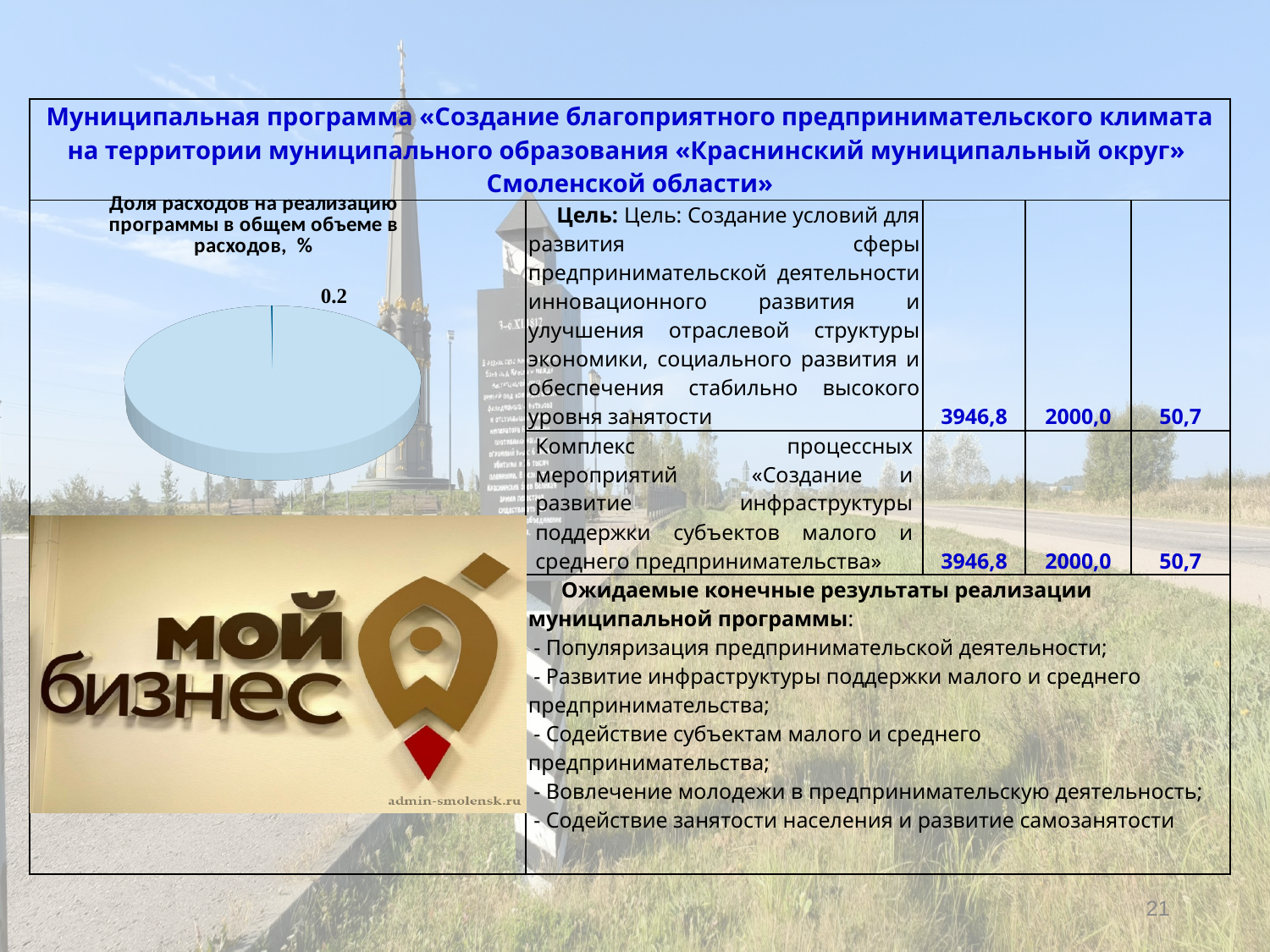
What kind of chart is shown on the left of the slide? pie chart How many data labels are printed on the pie chart? 1 Does the pie chart show a legend? No What is the title of the pie chart on the slide? Доля расходов на реализацию программы в общем объеме в расходов, % What value is printed as the data label on the pie chart? 0.2 Is the slice labeled 0.2 on the pie chart the larger or the smaller of the two slices? smaller